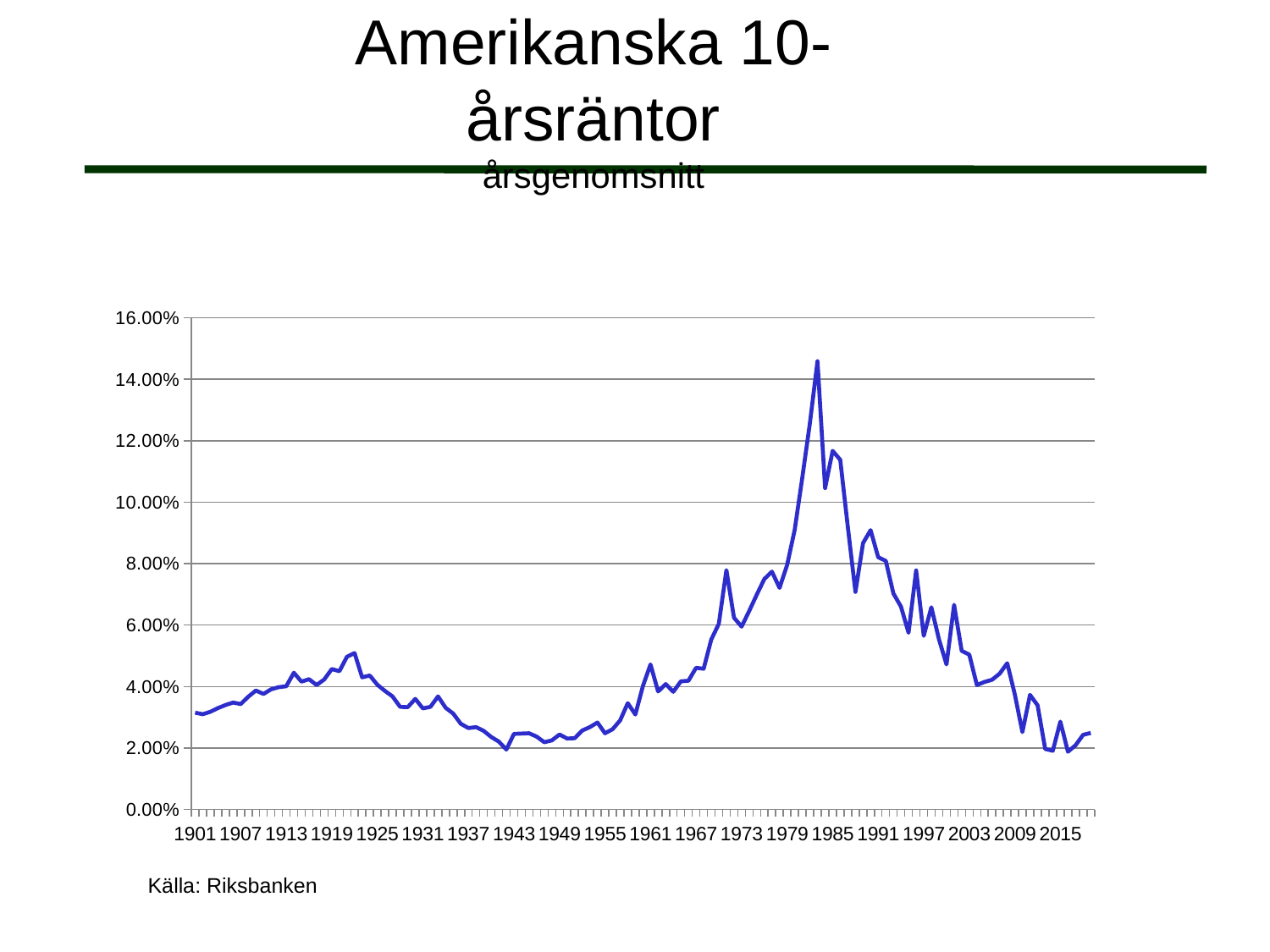
What source is cited below the chart? Riksbanken What is the title of the chart on the slide? Amerikanska 10-årsräntor Is the value for 1943 greater or less than 4.00%? less What kind of chart is shown on the slide? line chart Is the highest value on the line greater or less than 14.00%? greater Is the value for 1991 greater or less than 6.00%? greater Which is larger, the value for 1901 or the value for 1985? 1985 Do the values generally rise or fall from 1985 to 2015? fall Which is larger, the value for 1921 or the value for 1943? 1921